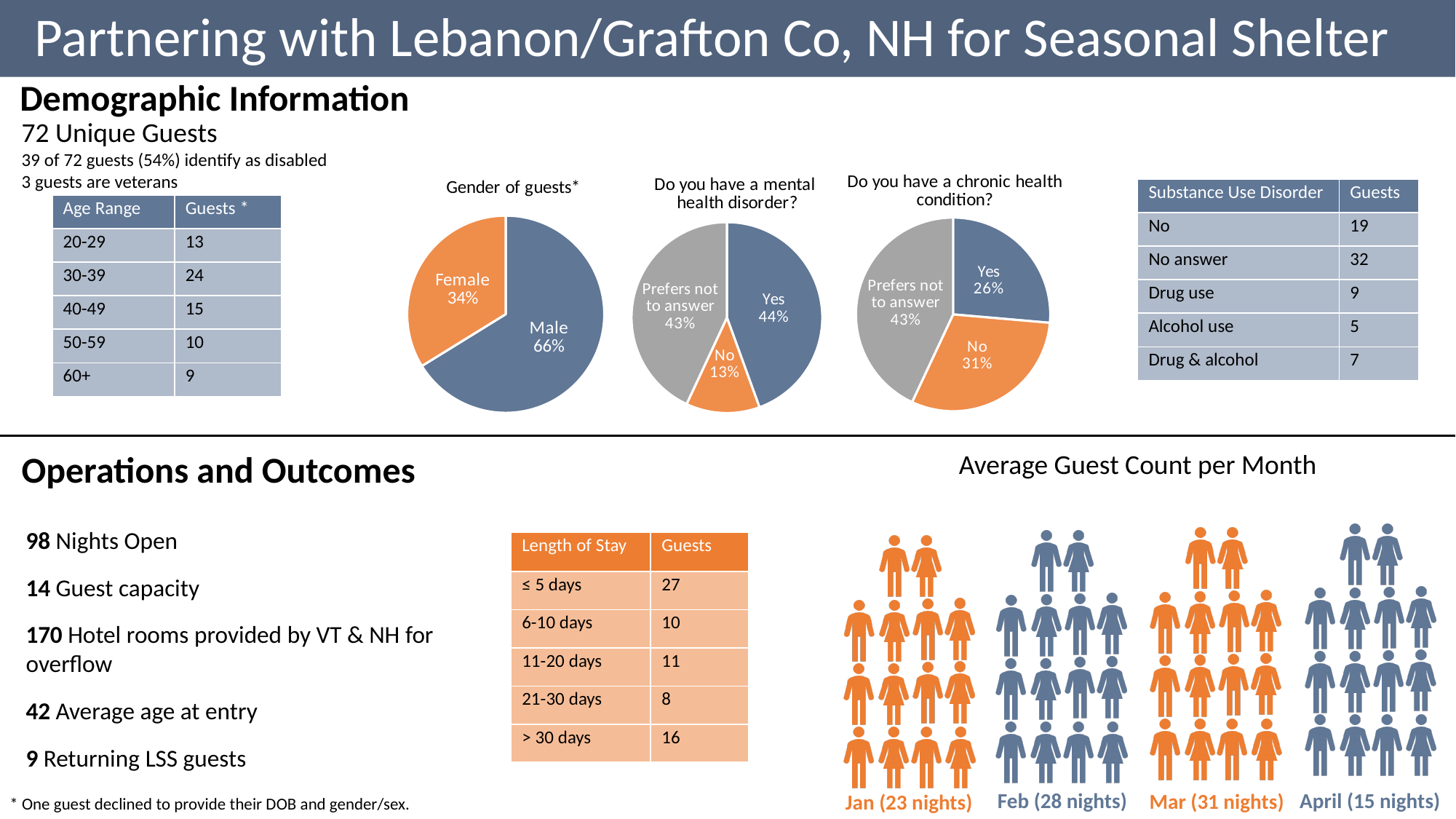
In the 'Gender of guests*' pie chart, what share of guests are Male? 66% In the 'Do you have a chronic health condition?' pie chart, which slice is the largest? Prefers not to answer In the 'Gender of guests*' pie chart, which slice is larger, Male or Female? Male In the 'Do you have a mental health disorder?' pie chart, what percentage answered Yes? 44% In the 'Gender of guests*' pie chart, what percentage is labelled Female? 34% In the 'Do you have a mental health disorder?' pie chart, what percentage answered No? 13% In the 'Do you have a mental health disorder?' pie chart, which slice is the smallest? No How many slices does the 'Do you have a chronic health condition?' pie chart have? 3 In the 'Do you have a mental health disorder?' pie chart, how many percentage points larger is the Yes slice than the No slice? 31 percentage points What kind of chart is used to show 'Gender of guests*'? Pie chart In the 'Do you have a chronic health condition?' pie chart, what percentage answered Yes? 26% In the 'Do you have a chronic health condition?' pie chart, which slice is larger, Yes or No? No